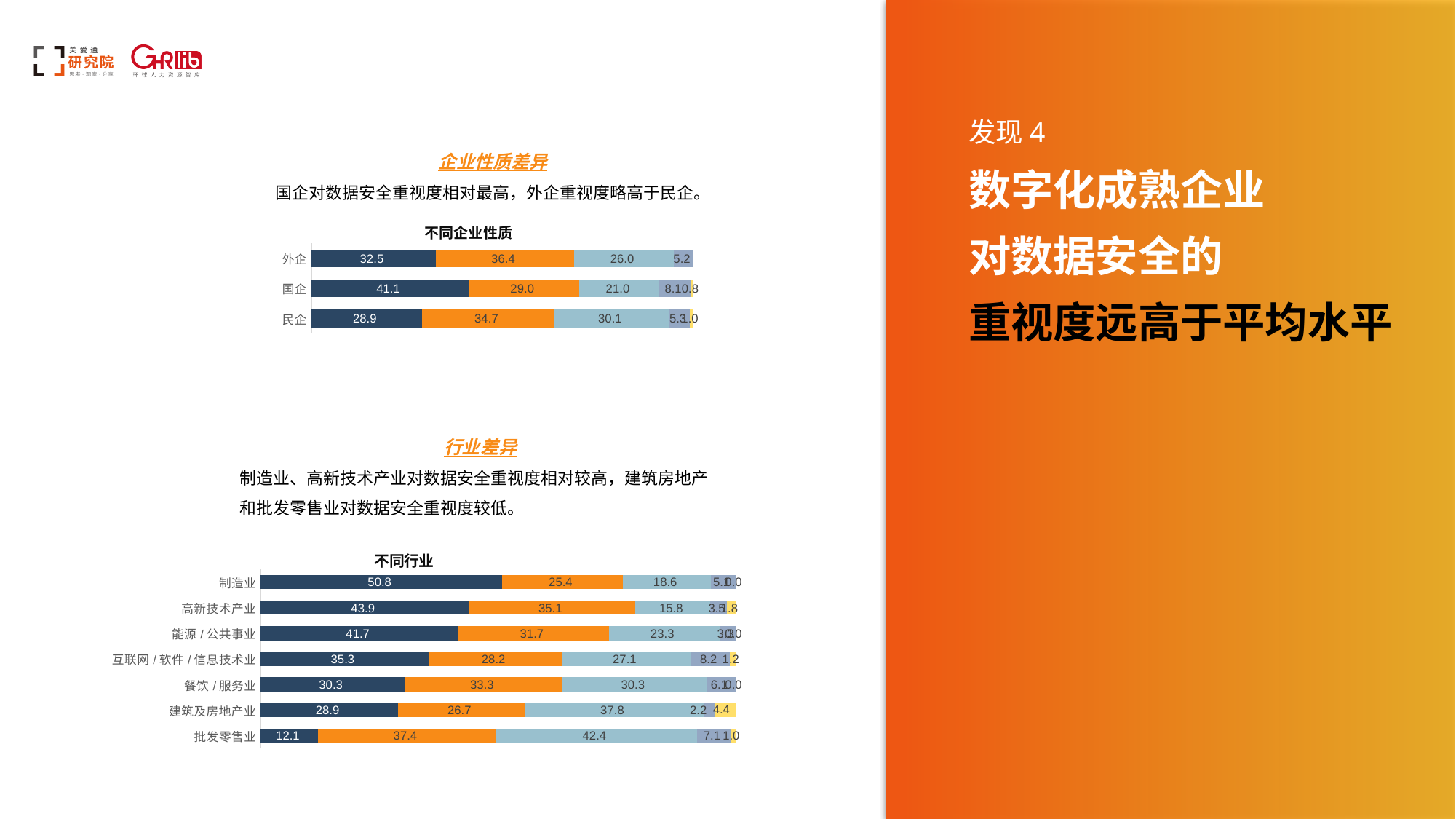
In the "不同行业" chart, what is the value of the light blue (third) segment for 批发零售业? 42.4 In the "不同企业性质" chart, what is the difference between the dark blue segment values of 国企 and 民企? 12.2 In the "不同行业" chart, which has a larger orange (second) segment: 高新技术产业 or 建筑及房地产业? 高新技术产业 How many categories are shown in the "不同企业性质" chart? 3 What type of chart is the "不同企业性质" chart? Stacked bar chart In the "不同行业" chart, what is the value of the dark blue (first) segment for 制造业? 50.8 In the "不同企业性质" chart, which category has the largest dark blue (first) segment? 国企 In the "不同企业性质" chart, what is the value of the orange (second) segment for 外企? 36.4 In the "不同行业" chart, which category has the smallest dark blue (first) segment? 批发零售业 How many categories are shown in the "不同行业" chart? 7 In the "不同行业" chart, what is the value of the light blue (third) segment for 互联网 / 软件 / 信息技术业? 27.1 In the "不同企业性质" chart, what is the value of the dark blue (first) segment for 国企? 41.1